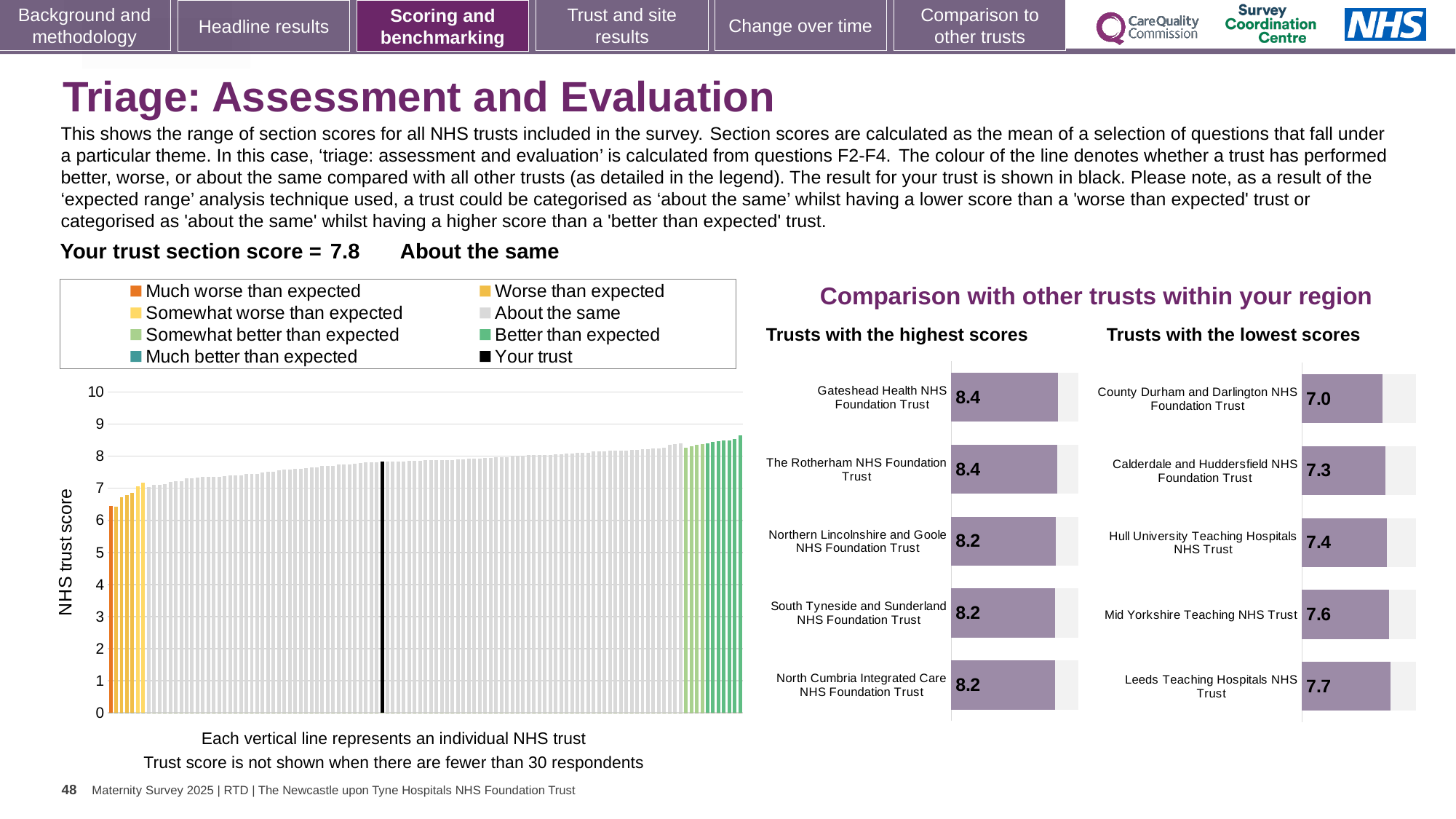
In the 'Trusts with the lowest scores' chart, what is the score for Leeds Teaching Hospitals NHS Trust? 7.7 What kind of chart is the main NHS trust score chart on the left of the slide? Bar chart How many trusts are shown in the 'Trusts with the highest scores' chart? 5 In the 'Trusts with the lowest scores' chart, which has the larger score: Hull University Teaching Hospitals NHS Trust or Mid Yorkshire Teaching NHS Trust? Mid Yorkshire Teaching NHS Trust In the 'Trusts with the highest scores' chart, what is the score for Gateshead Health NHS Foundation Trust? 8.4 In the main NHS trust score chart on the left, is the value of the leftmost bar greater or less than 7? less In the 'Trusts with the lowest scores' chart, which trust has the lowest score? County Durham and Darlington NHS Foundation Trust In the 'Trusts with the lowest scores' chart, which trust has the highest score? Leeds Teaching Hospitals NHS Trust What is the difference between the score for Gateshead Health NHS Foundation Trust in the highest scores chart and the score for County Durham and Darlington NHS Foundation Trust in the lowest scores chart? 1.4 How many entries does the legend of the main NHS trust score chart on the left list? 8 In the main NHS trust score chart on the left, do the bar values rise or fall from left to right? Rise In the 'Trusts with the lowest scores' chart, what is the score for County Durham and Darlington NHS Foundation Trust? 7.0